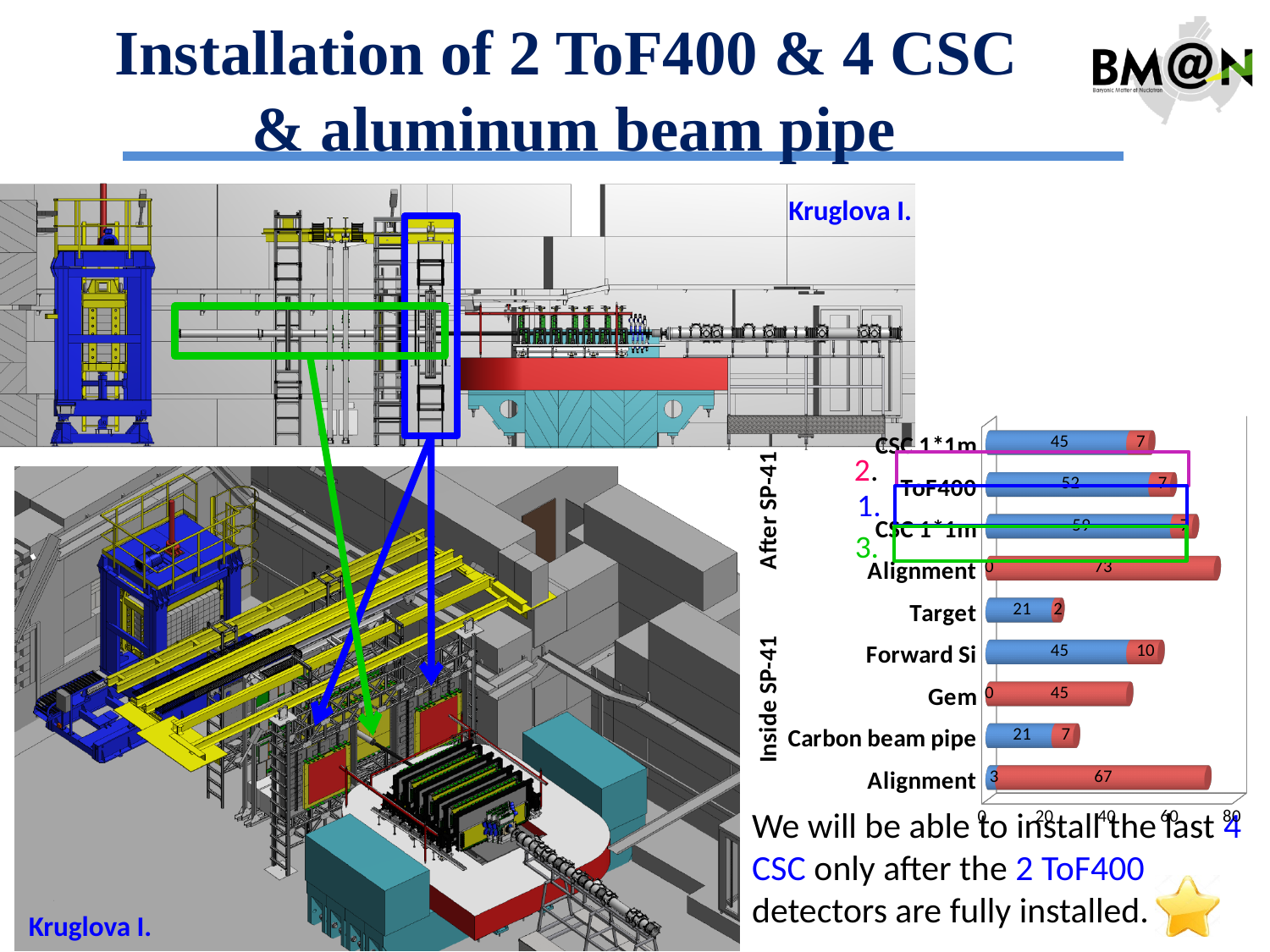
In the chart, what is the difference between the blue segment of ToF400 and the blue segment of the topmost CSC 1*1m bar? 7 What kind of chart is shown on the right side of the slide? bar chart How many category bars does the chart on the right show? 9 In the chart, which has the larger red segment: Forward Si or Carbon beam pipe? Forward Si In the chart, what is the total of the Forward Si bar? 55 In the chart, what is the red segment value for Forward Si? 10 In the chart, what is the blue segment value for ToF400? 52 In the chart, what is the red segment value for the bottom Alignment bar? 67 In the chart, what is the red segment value for Gem? 45 In the chart, what is the blue segment value for Forward Si? 45 In the chart, what is the total of the Carbon beam pipe bar? 28 In the chart, what is the blue segment value for Target? 21